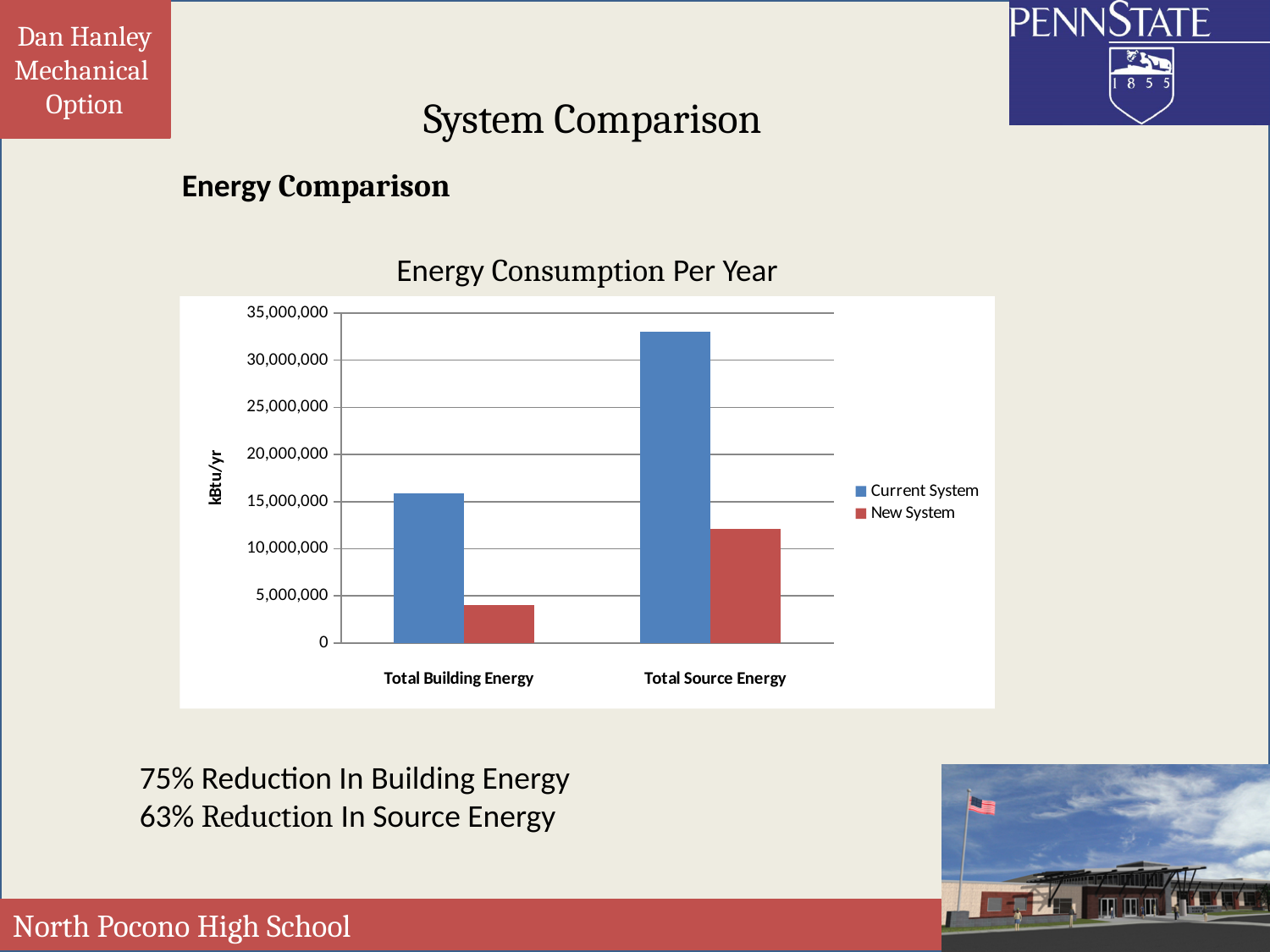
How many series does the chart legend list? 2 Is the New System value for Total Source Energy greater or less than 10,000,000? greater Which category has the highest Current System value? Total Source Energy Which category has the lowest New System value? Total Building Energy Is the Current System value for Total Building Energy greater or less than 15,000,000? greater What is the label on the vertical axis of the chart? kBtu/yr What type of chart is shown on the slide? bar chart What is the title of the chart? Energy Consumption Per Year Is the New System value for Total Building Energy greater or less than 5,000,000? less Which series has the higher value for Total Source Energy, Current System or New System? Current System How many categories are shown on the x axis of the chart? 2